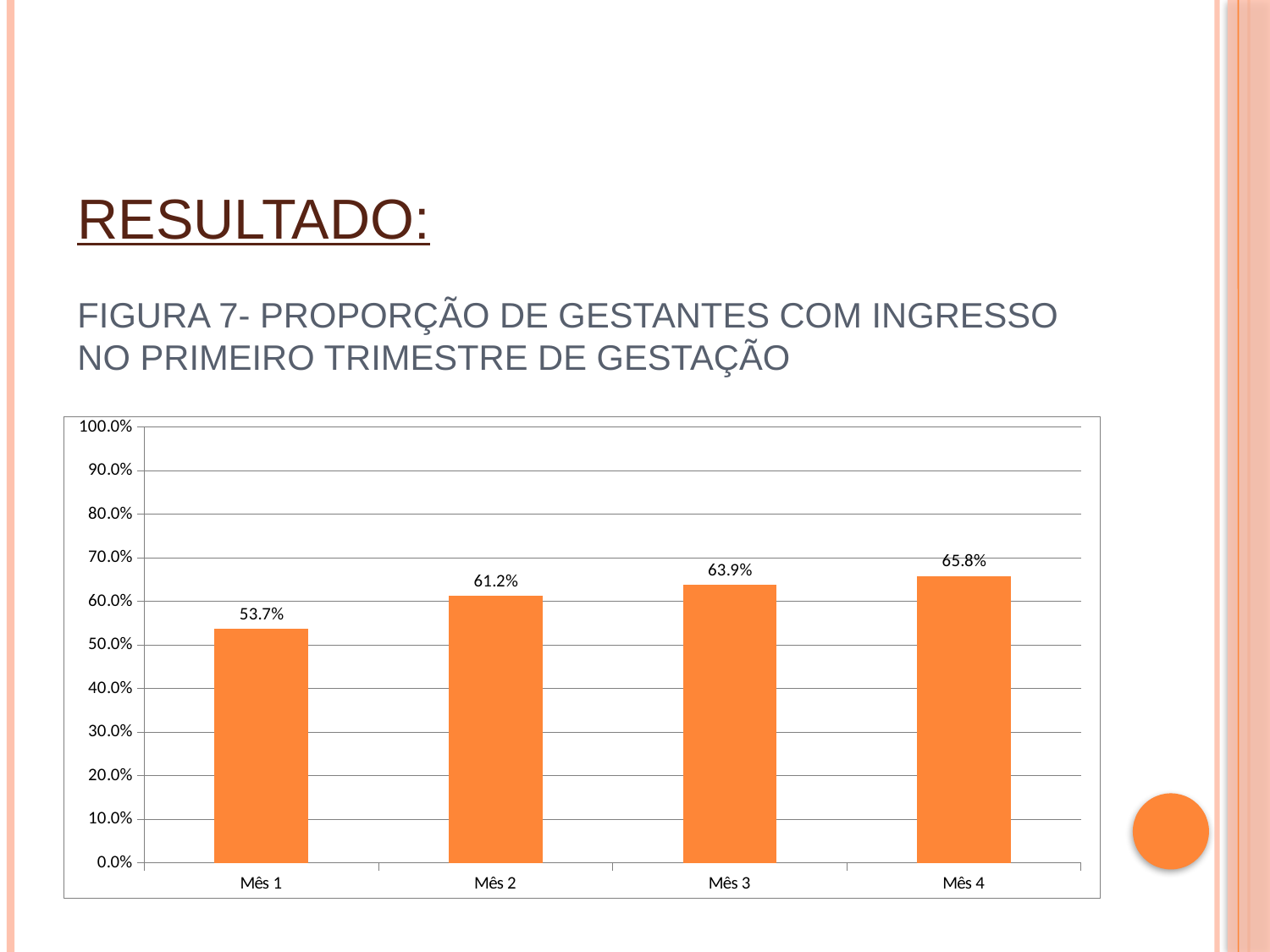
What is the value for Mês 1? 53.7% Which month has the highest value? Mês 4 What is the value for Mês 2? 61.2% Which is larger, the value for Mês 2 or the value for Mês 3? Mês 3 What kind of chart is shown on the slide? bar chart Is the value for Mês 1 greater or less than 60.0%? less What is the value for Mês 3? 63.9% Which month has the lowest value? Mês 1 Do the values rise or fall from Mês 1 to Mês 4? rise How many months are shown on the x axis? 4 What is the value for Mês 4? 65.8% What is the difference between the values for Mês 4 and Mês 1? 12.1%